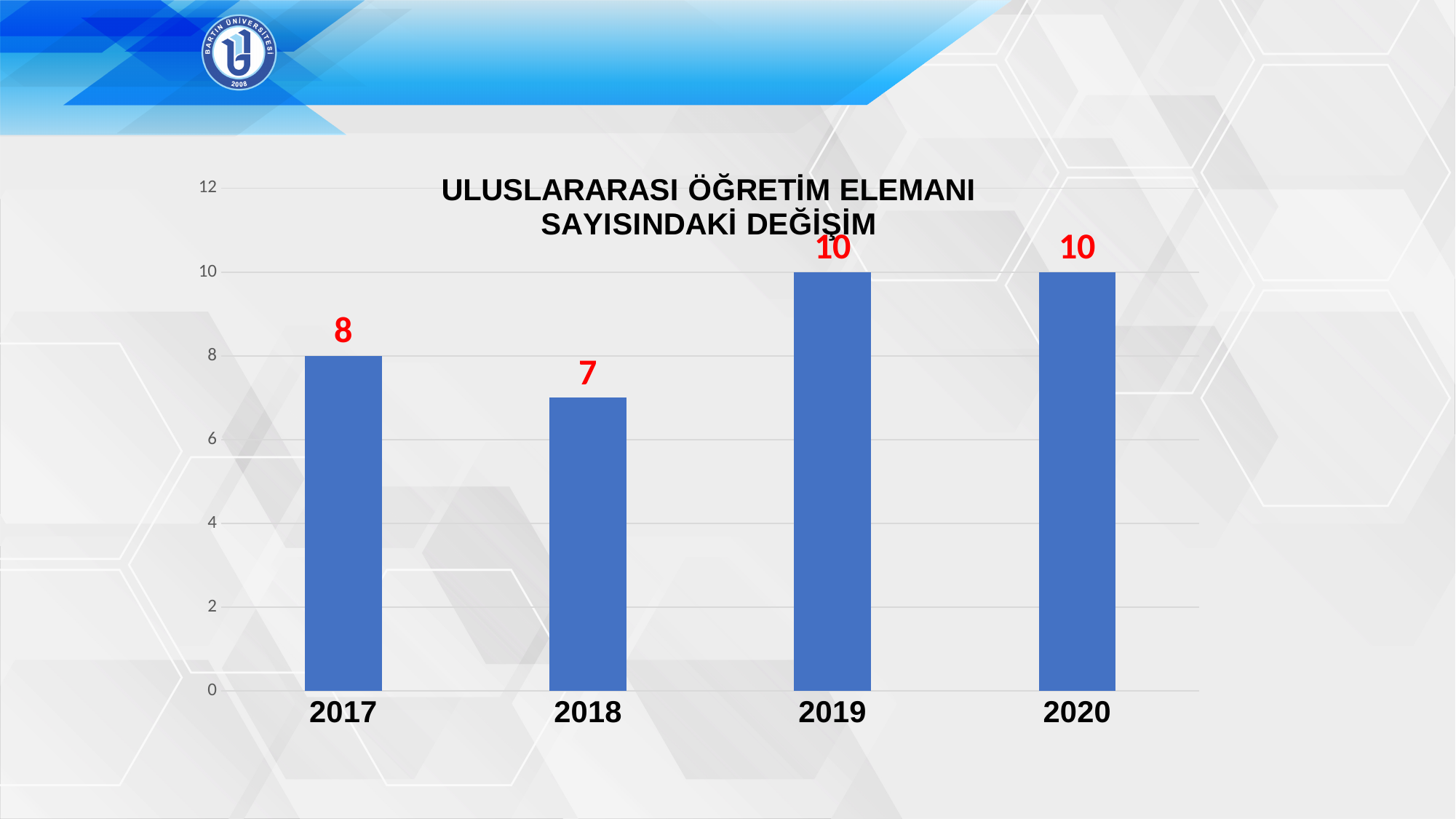
What is the value for 2019? 10 Which is larger, the value for 2017 or the value for 2018? 2017 What is the difference between the values for 2017 and 2018? 1 How many years are shown on the x axis? 4 What is the difference between the values for 2019 and 2018? 3 Is the value for 2018 greater or less than 8? less What kind of chart is shown on the slide? bar chart What is the value for 2020? 10 What is the title of the chart? ULUSLARARASI ÖĞRETİM ELEMANI SAYISINDAKİ DEĞİŞİM What is the value for 2017? 8 Which year has the lowest value? 2018 What is the value for 2018? 7